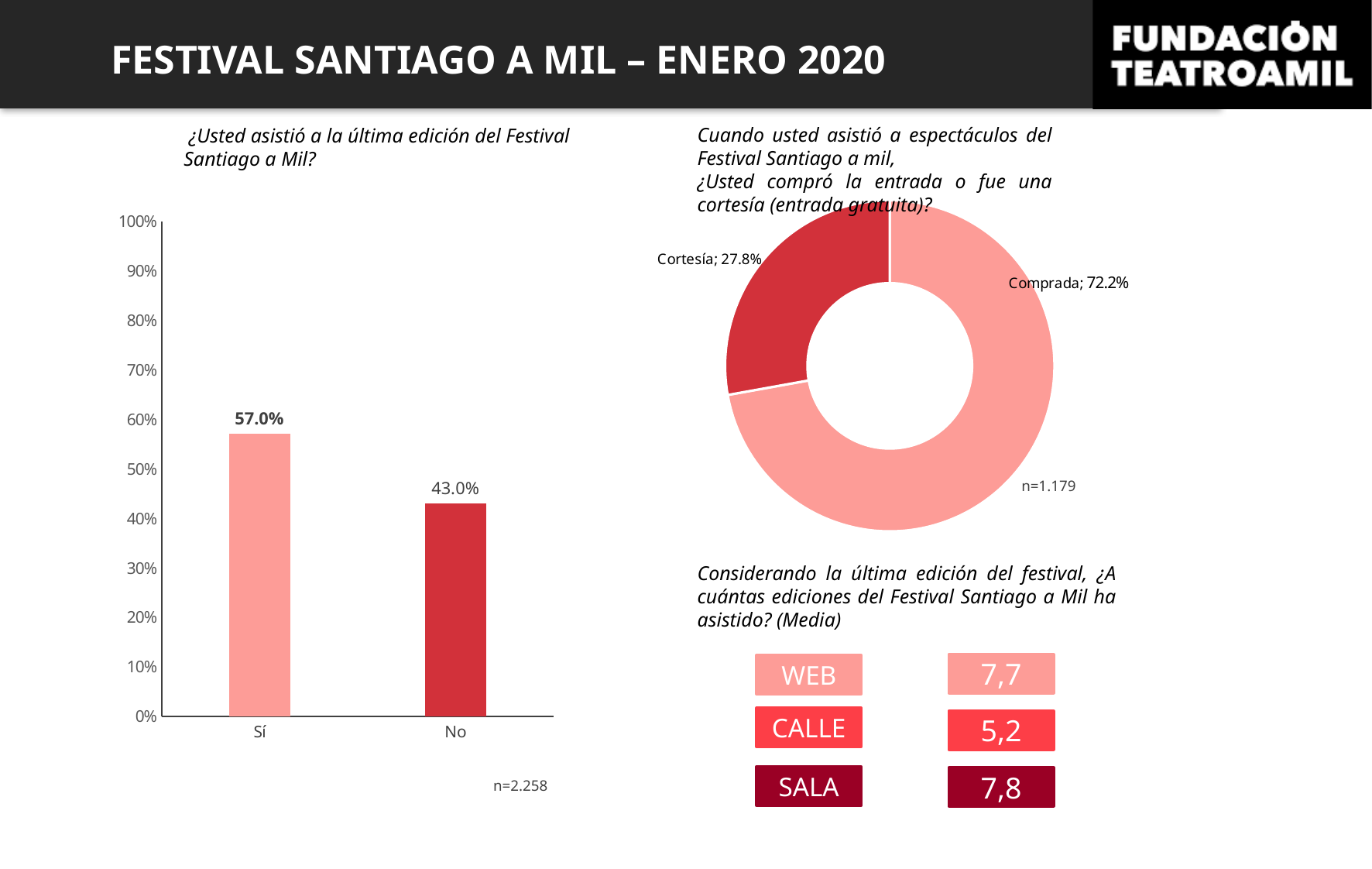
In the doughnut chart on the right, what share of tickets were "Comprada"? 72.2% In the doughnut chart on the right, which slice is the largest? Comprada In the bar chart on the left, what is the difference between the Sí and No percentages? 14.0% In the bar chart on the left, is the value for No greater or less than 50%? less In the doughnut chart on the right, what share of tickets were "Cortesía"? 27.8% What sample size (n) is shown below the bar chart on the left? n=2.258 In the bar chart on the left, what percentage of respondents answered "No"? 43.0% In the bar chart on the left, what percentage of respondents answered "Sí"? 57.0% In the doughnut chart on the right, how many slices are there? 2 In the bar chart on the left, which category has the higher value, Sí or No? Sí In the bar chart on the left, how many categories are shown on the x axis? 2 What type of chart is the chart on the left of the slide? Bar chart